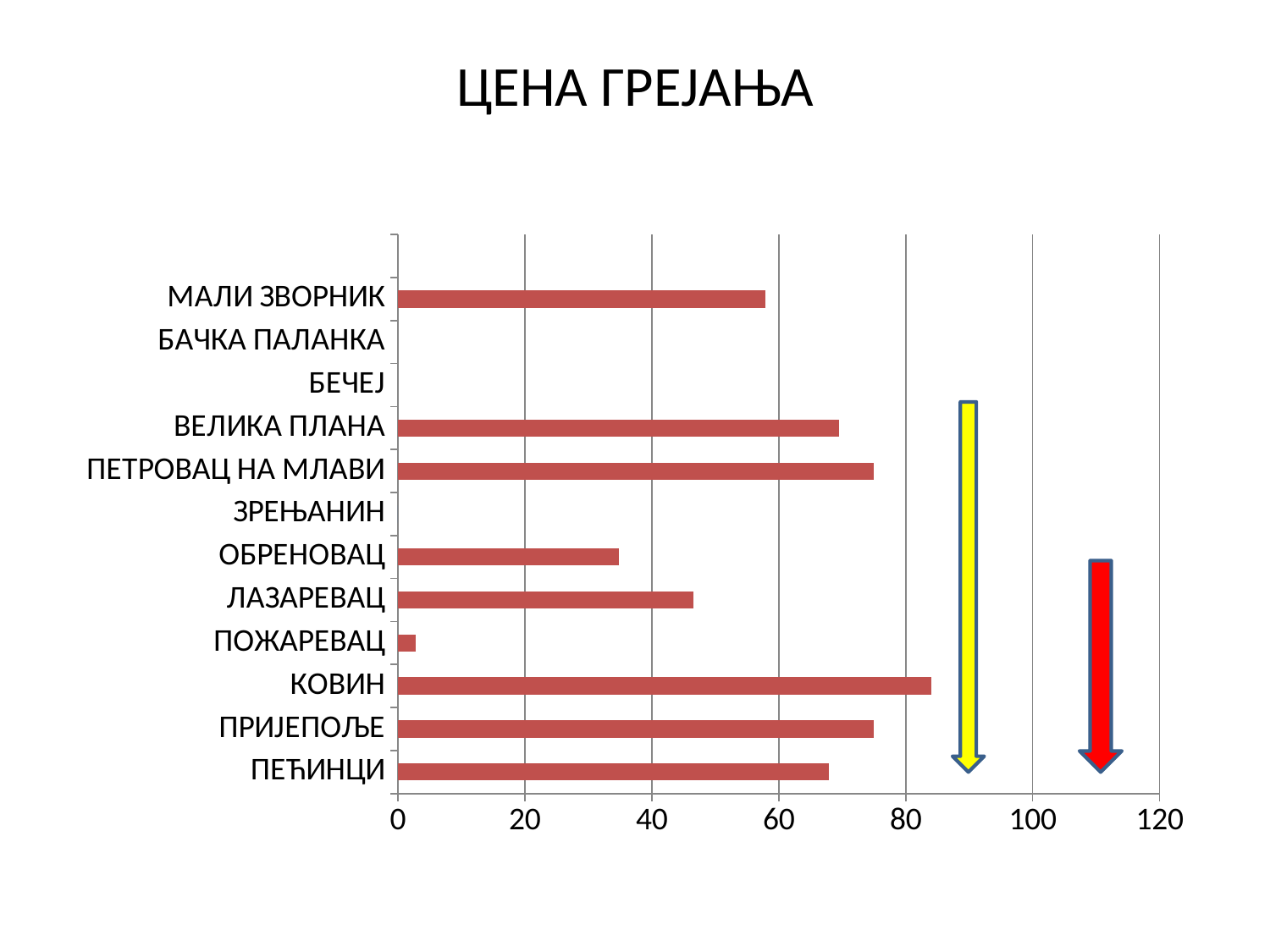
Is the value for КОВИН greater or less than 80? greater Among the categories with a visible bar, which has the shortest bar? ПОЖАРЕВАЦ Which category has the longest bar in the chart? КОВИН Is the value for МАЛИ ЗВОРНИК greater or less than 60? less Is the value for ОБРЕНОВАЦ greater or less than 40? less What is the title of the chart? ЦЕНА ГРЕЈАЊА Which is larger, the value for ЛАЗАРЕВАЦ or the value for ПЕЋИНЦИ? ПЕЋИНЦИ What is the highest value shown on the horizontal axis of the chart? 120 What kind of chart is shown on the slide? bar chart Which is larger, the value for КОВИН or the value for ОБРЕНОВАЦ? КОВИН How many categories are listed on the vertical axis of the chart? 12